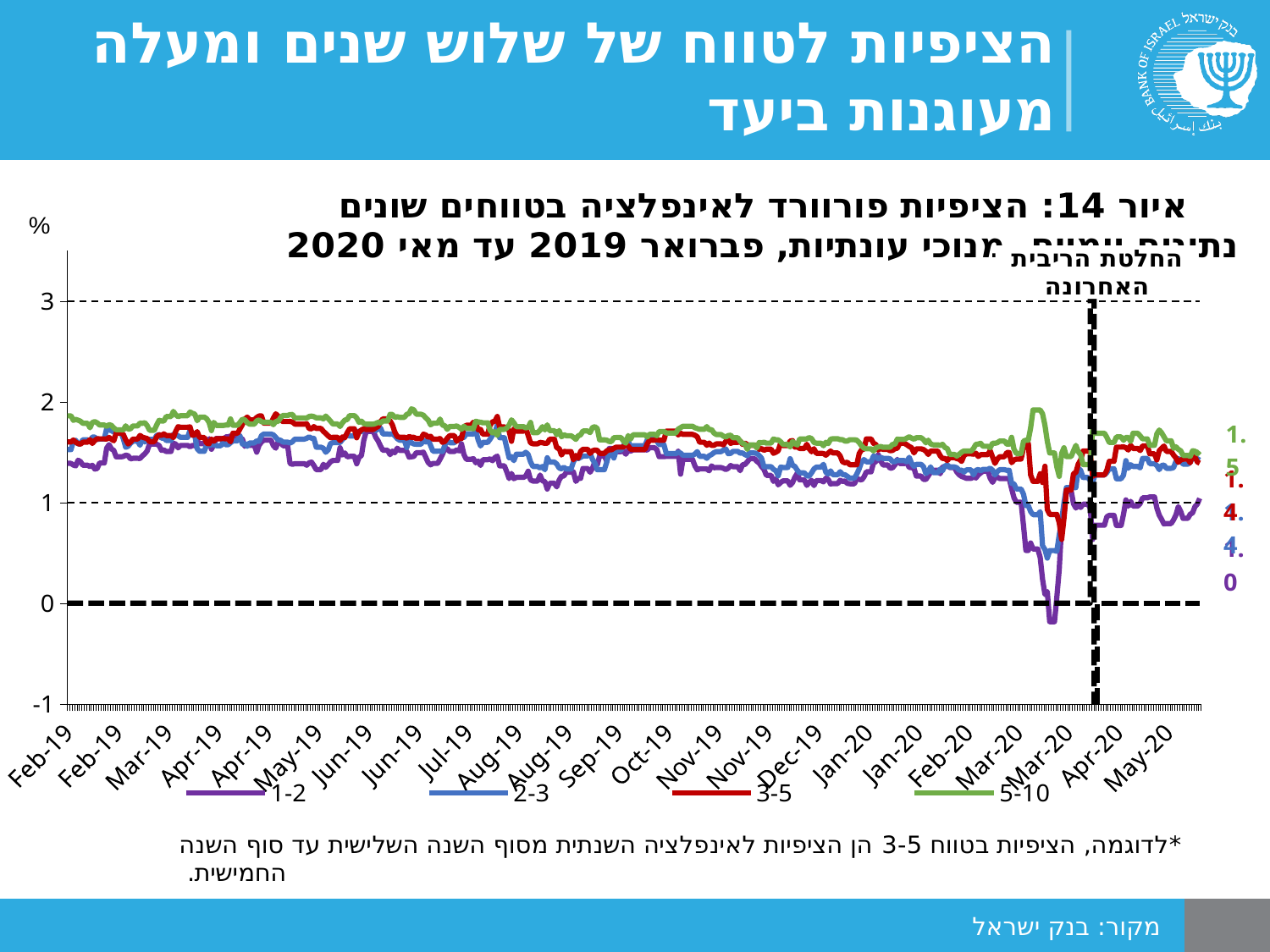
What kind of chart is shown on the slide? line chart Is the value of the 5-10 series at Feb-19 greater or less than 1? greater Which series reaches the lowest value anywhere on the chart? 1-2 At Feb-19, which series is larger, 5-10 or 1-2? 5-10 What is the highest value shown on the y axis? 3 Is the value of the 1-2 series at May-20 greater or less than 2? less What are the series names listed in the legend? 1-2, 2-3, 3-5, 5-10 How many series does the legend list? 4 Does the 1-2 series rise or fall overall from Feb-19 to May-20? fall What unit is shown on the y axis? % Which series is highest at the start of the chart (Feb-19)? 5-10 Is the lowest point of the 1-2 series greater or less than 0? less